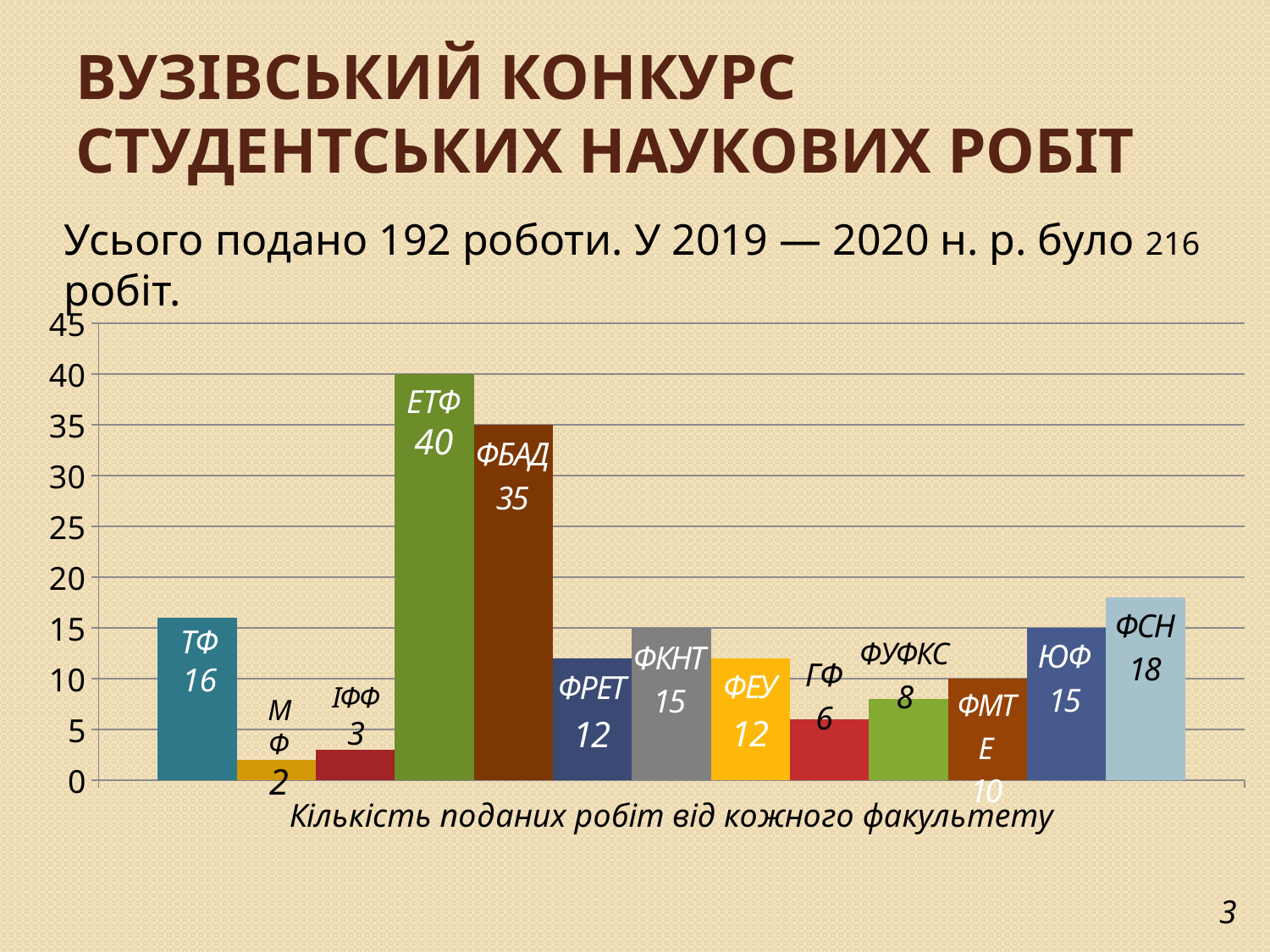
What type of chart is shown on the slide? bar chart What is the caption/title shown below the chart? Кількість поданих робіт від кожного факультету What is the value for ФУФКС? 8 How many bars (faculties) are plotted in the chart? 13 Which faculty has the lowest number of submitted works? МФ What is the value for ФСН? 18 What is the value for ЕТФ? 40 What is the difference between the values for ФСН and ГФ? 12 Which faculty has the highest number of submitted works? ЕТФ What is the difference between the values for ЕТФ and ФБАД? 5 Which is larger, the value for ТФ or the value for ЮФ? ТФ Is the value for ФБАД greater or less than 30? greater